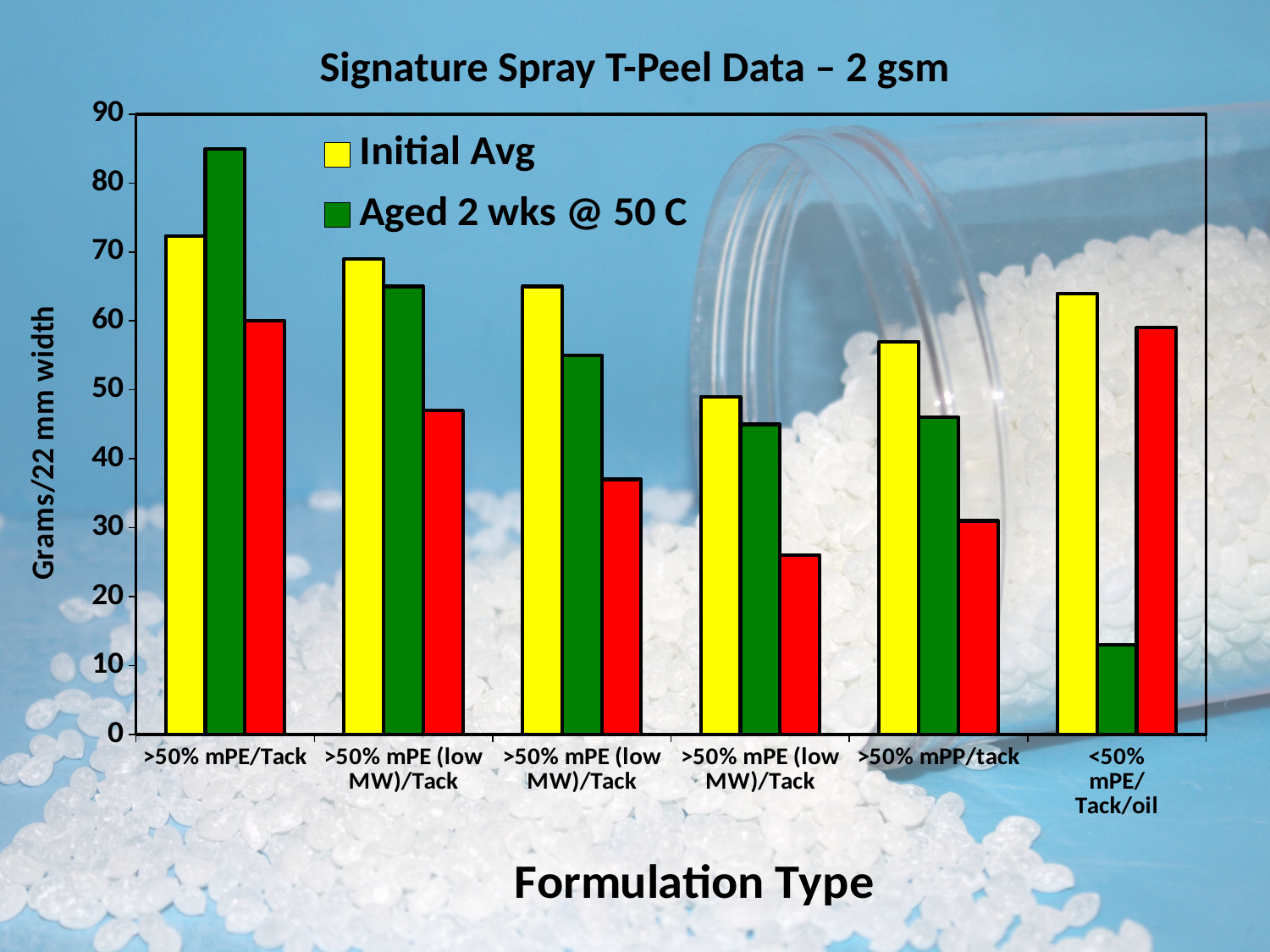
Is the Initial Avg value for >50% mPE/Tack greater or less than 60? greater Is the Aged 2 wks @ 50 C value for >50% mPE/Tack greater or less than 80? greater Which formulation type has the highest Aged 2 wks @ 50 C value? >50% mPE/Tack How many formulation types are shown along the x axis? 6 What kind of chart is shown on the slide? bar chart For <50% mPE/Tack/oil, which is higher: Initial Avg or Aged 2 wks @ 50 C? Initial Avg Is the Aged 2 wks @ 50 C value for <50% mPE/Tack/oil greater or less than 20? less What is the title of the chart? Signature Spray T-Peel Data – 2 gsm How many series does the legend list? 2 Which formulation type has the lowest Aged 2 wks @ 50 C value? <50% mPE/Tack/oil For >50% mPE/Tack, which is higher: Initial Avg or Aged 2 wks @ 50 C? Aged 2 wks @ 50 C